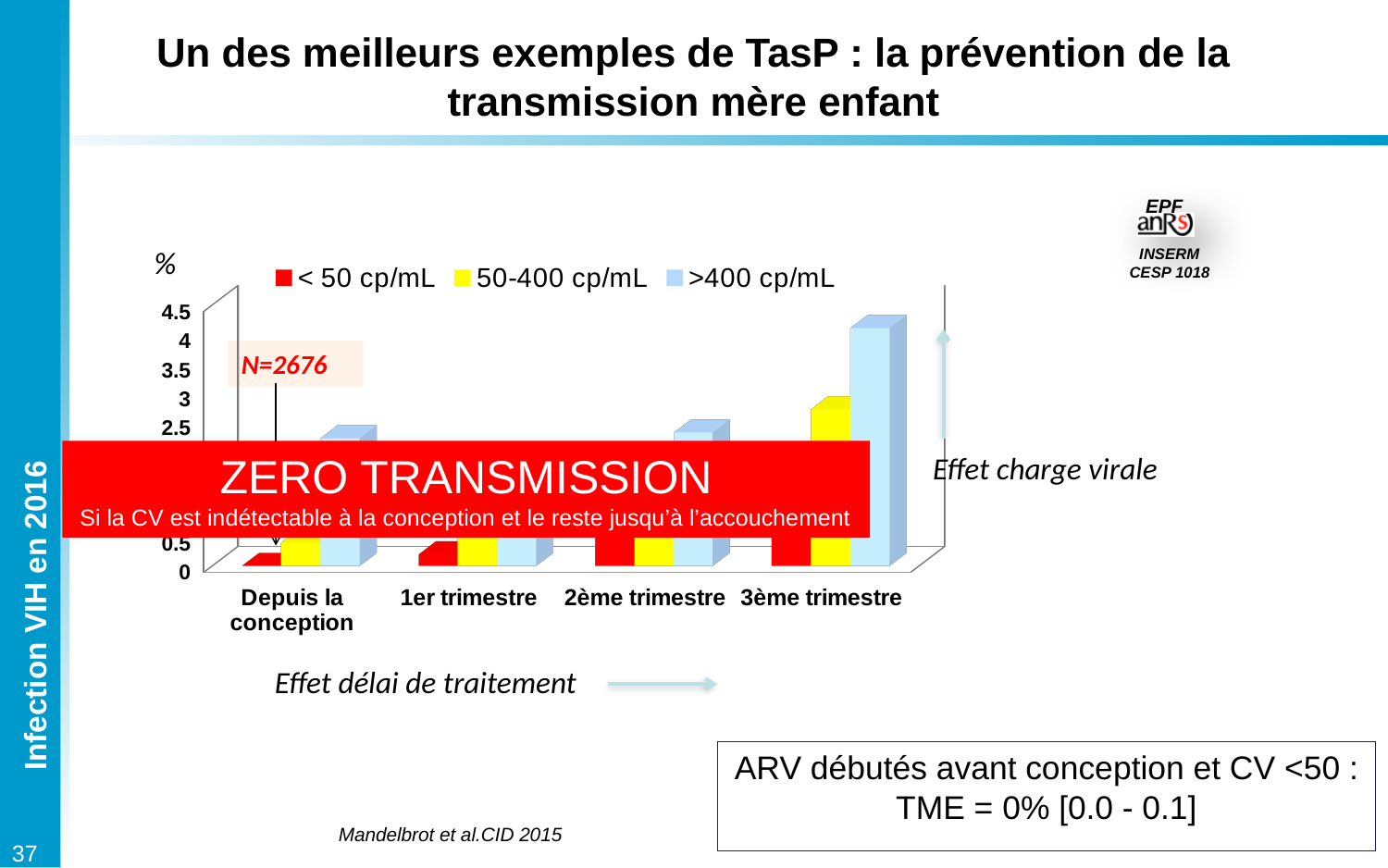
How many categories are shown along the x axis of the chart? 4 Which series has the tallest bar in the 3ème trimestre category? >400 cp/mL Which is larger: the >400 cp/mL bar for 3ème trimestre or the >400 cp/mL bar for 2ème trimestre? 3ème trimestre Which category has the highest bar for the >400 cp/mL series? 3ème trimestre What are the three legend entries of the chart? < 50 cp/mL, 50-400 cp/mL, >400 cp/mL What kind of chart is shown on the slide? bar chart How many series does the chart legend list? 3 Is the value for >400 cp/mL in the 3ème trimestre category greater or less than 4? greater What sample size (N) is annotated on the chart? N=2676 Is the value for >400 cp/mL in the 2ème trimestre category greater or less than 3? less Is the value for 50-400 cp/mL in the 3ème trimestre category greater or less than 2? greater